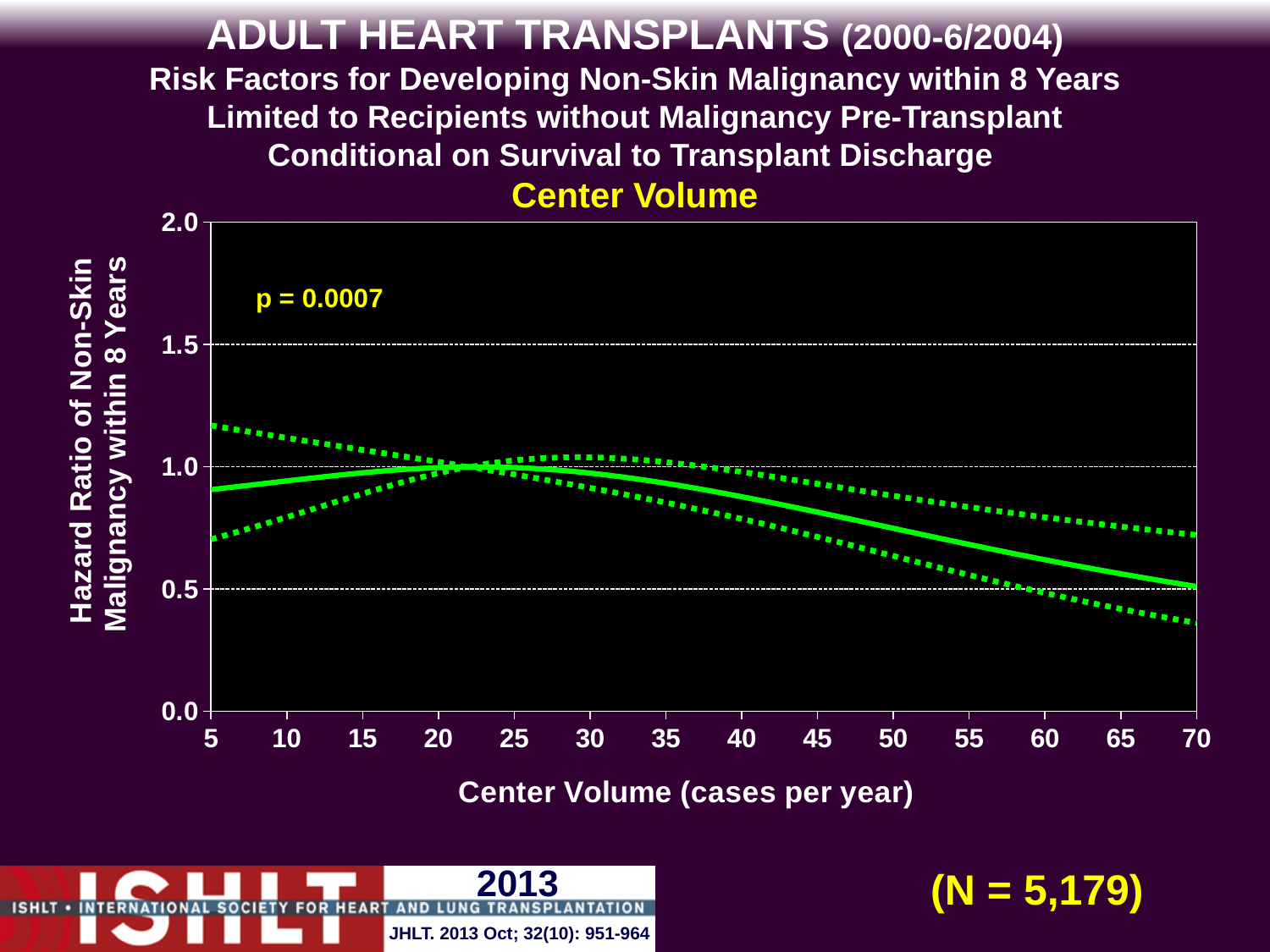
Does the solid line (hazard ratio) rise or fall as center volume increases from 25 to 70 cases per year? fall Is the value of the solid hazard ratio line at a center volume of 5 cases per year greater or less than 1.0? less Is the value of the upper dotted line at a center volume of 70 cases per year greater or less than 1.0? less What p-value is printed on the chart? p = 0.0007 What is the label of the x axis? Center Volume (cases per year) Is the value of the solid hazard ratio line at a center volume of 60 cases per year greater or less than 1.0? less What kind of chart is shown on the slide? line chart How many lines are plotted on the chart? 3 How many tick marks are labeled on the x axis (Center Volume)? 14